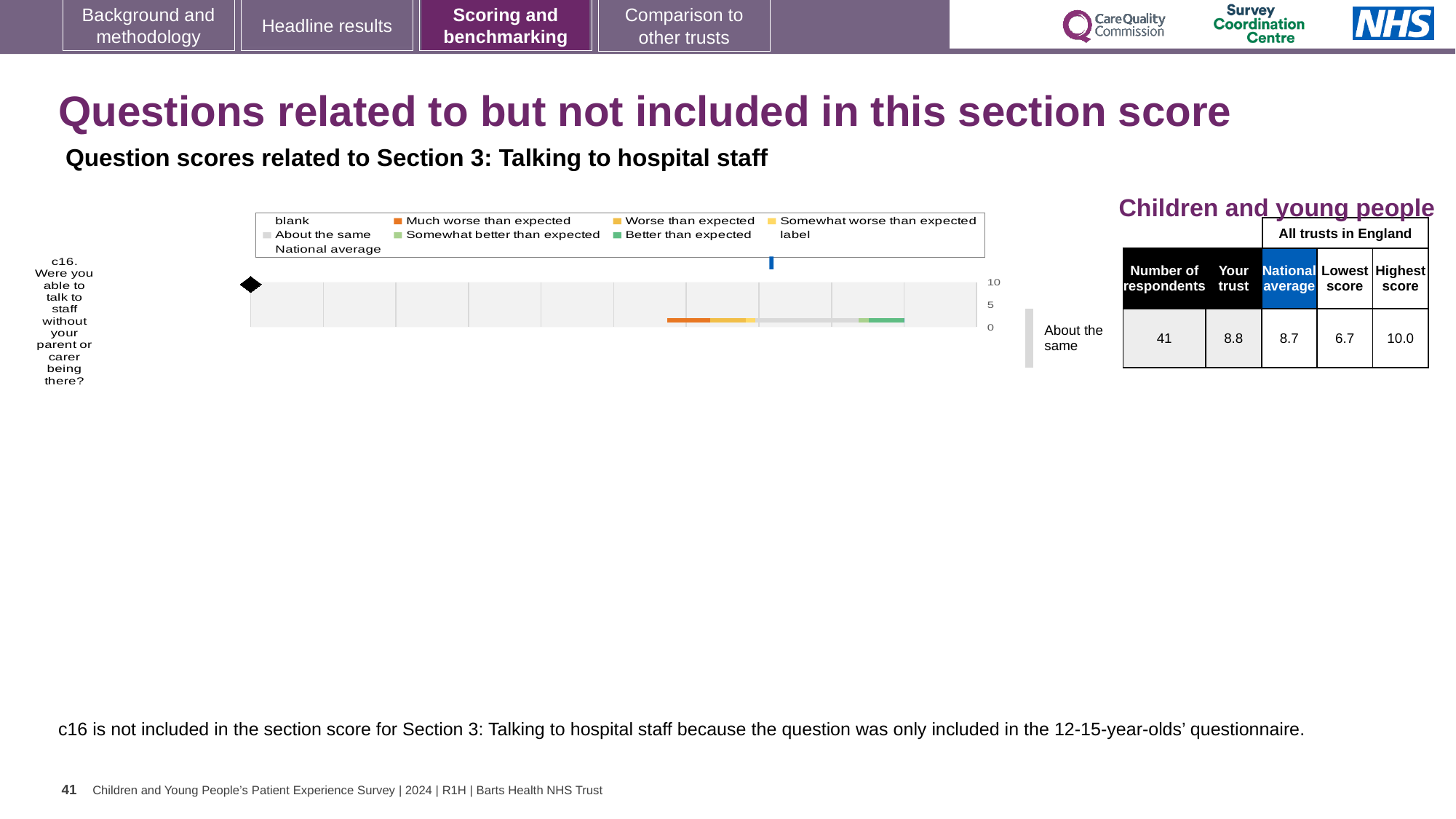
What is the lowest score across all trusts in England for c16? 6.7 What benchmark category is c16 placed in, as labelled next to the chart? About the same What is the difference between the highest score and the lowest score for c16? 3.3 What kind of chart is shown for question c16? bar chart What is the highest value shown on the chart's axis? 10 What is the highest score across all trusts in England for c16? 10.0 What is the 'Your trust' score for c16 in the table beside the chart? 8.8 How many survey questions are plotted in the chart? 1 Which question code is plotted in the chart? c16 What is the national average score for c16 in the table beside the chart? 8.7 Is the national average marker for c16 greater or less than 5 on the chart axis? greater How many respondents answered c16 according to the table beside the chart? 41